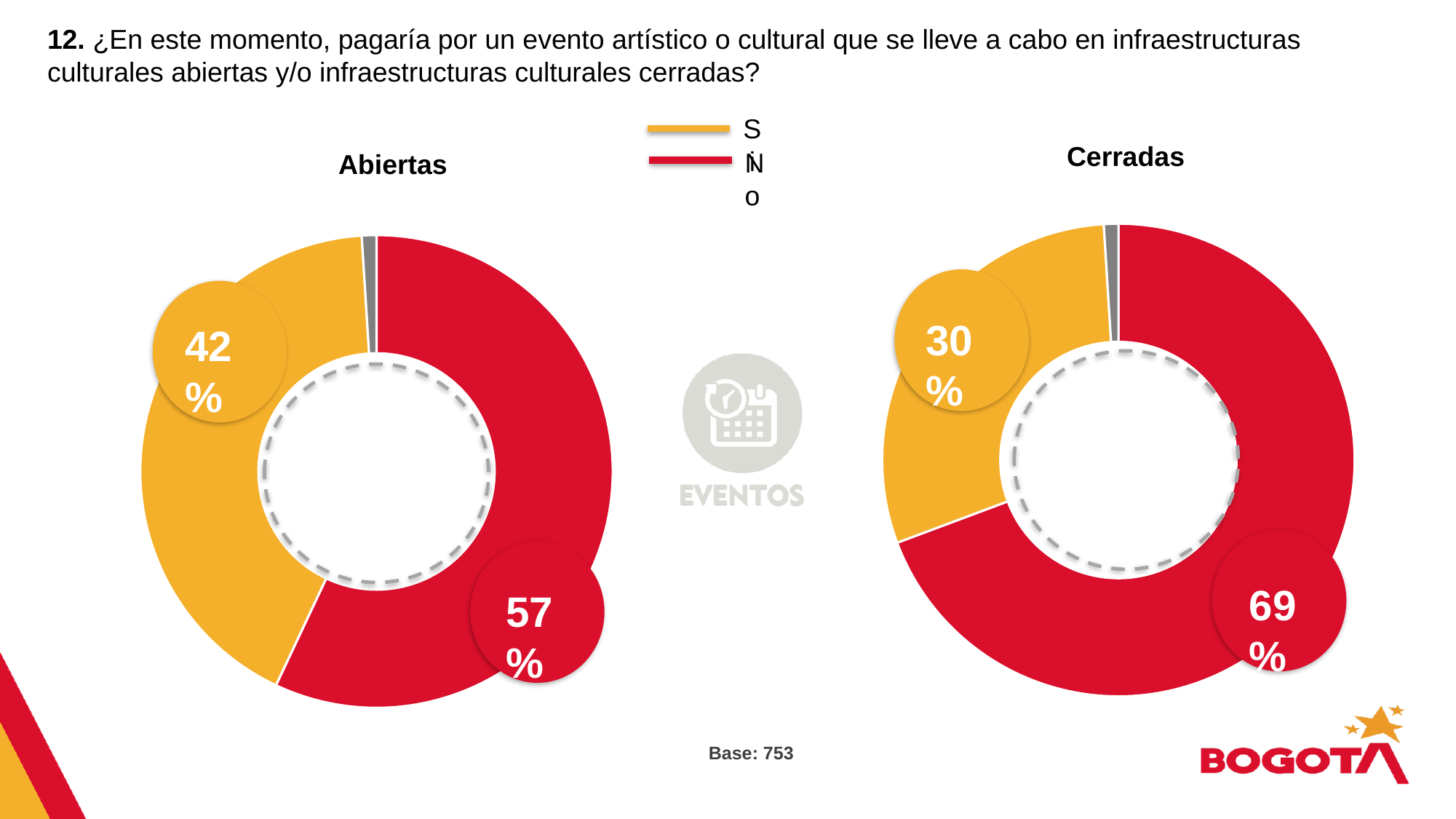
In the Abiertas chart, what is the difference in percentage points between the No and Sí shares? 15 Is the Sí share larger in the Abiertas chart or in the Cerradas chart? Abiertas How many series does the legend list? 2 In the Abiertas chart, what percentage of respondents answered No? 57% In the Abiertas chart, which labelled response has the smaller share, Sí or No? Sí Which colour represents the No response in the charts? Red What kind of chart is used for Abiertas and Cerradas? Donut (pie) chart In the Cerradas chart, which response has the largest share? No In the Abiertas chart, what percentage of respondents answered Sí? 42% In the Cerradas chart, what percentage of respondents answered No? 69% In the Cerradas chart, what percentage of respondents answered Sí? 30% In the Cerradas chart, what is the difference in percentage points between the No and Sí shares? 39